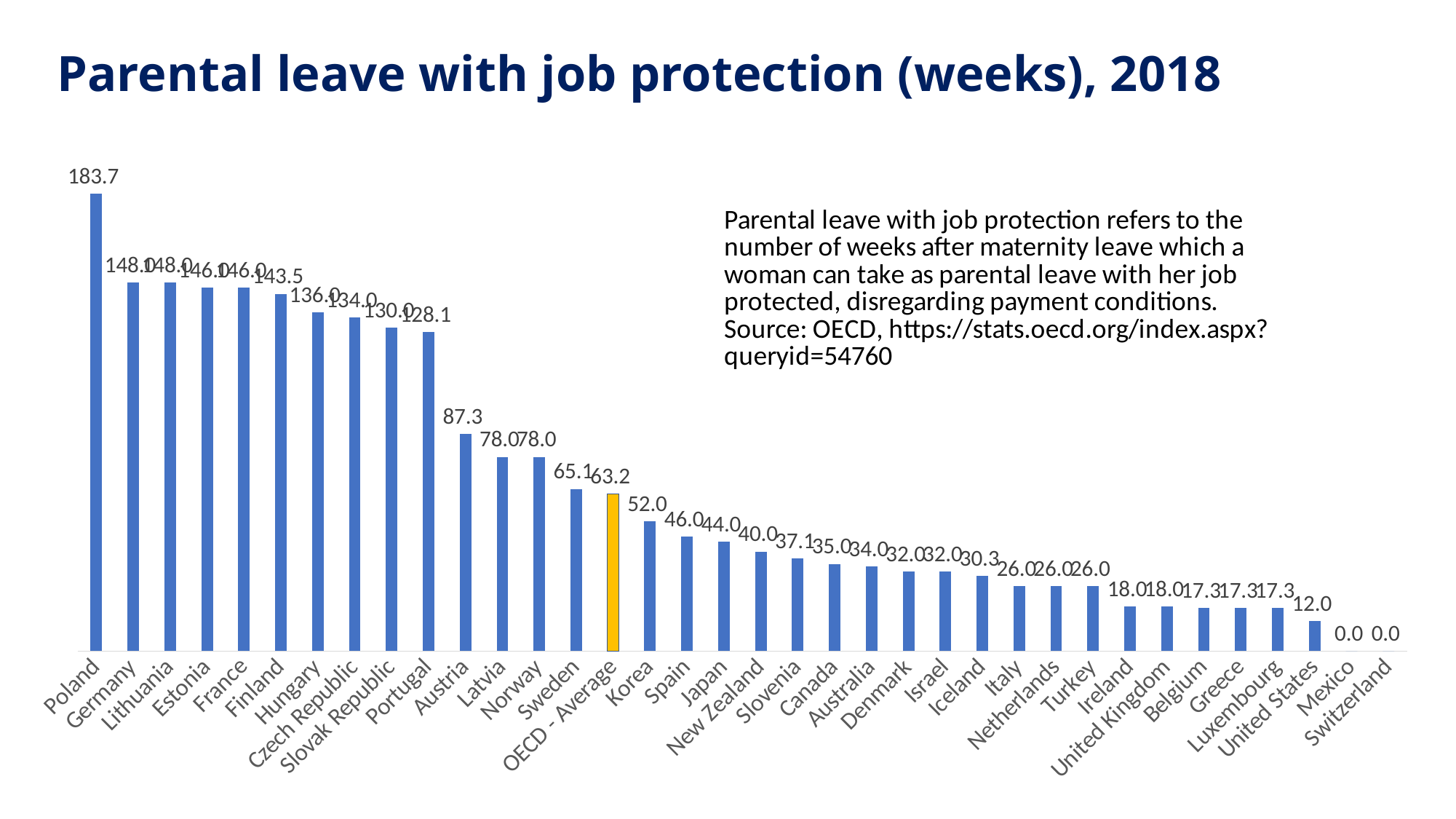
What is the value for Poland? 183.7 Which category has the highest value? Poland How many bars are plotted in the chart? 36 What is the difference between the values for Poland and Austria? 96.4 Do the values rise or fall from left to right along the x axis? Fall What is the value for the OECD - Average? 63.2 What is the value for Austria? 87.3 What kind of chart is shown on the slide? Bar chart Which is larger, the value for Iceland or the value for Slovenia? Slovenia What is the difference between the values for Sweden and Korea? 13.1 What is the value for the United States? 12.0 Which is larger, the value for Finland or the value for Hungary? Finland